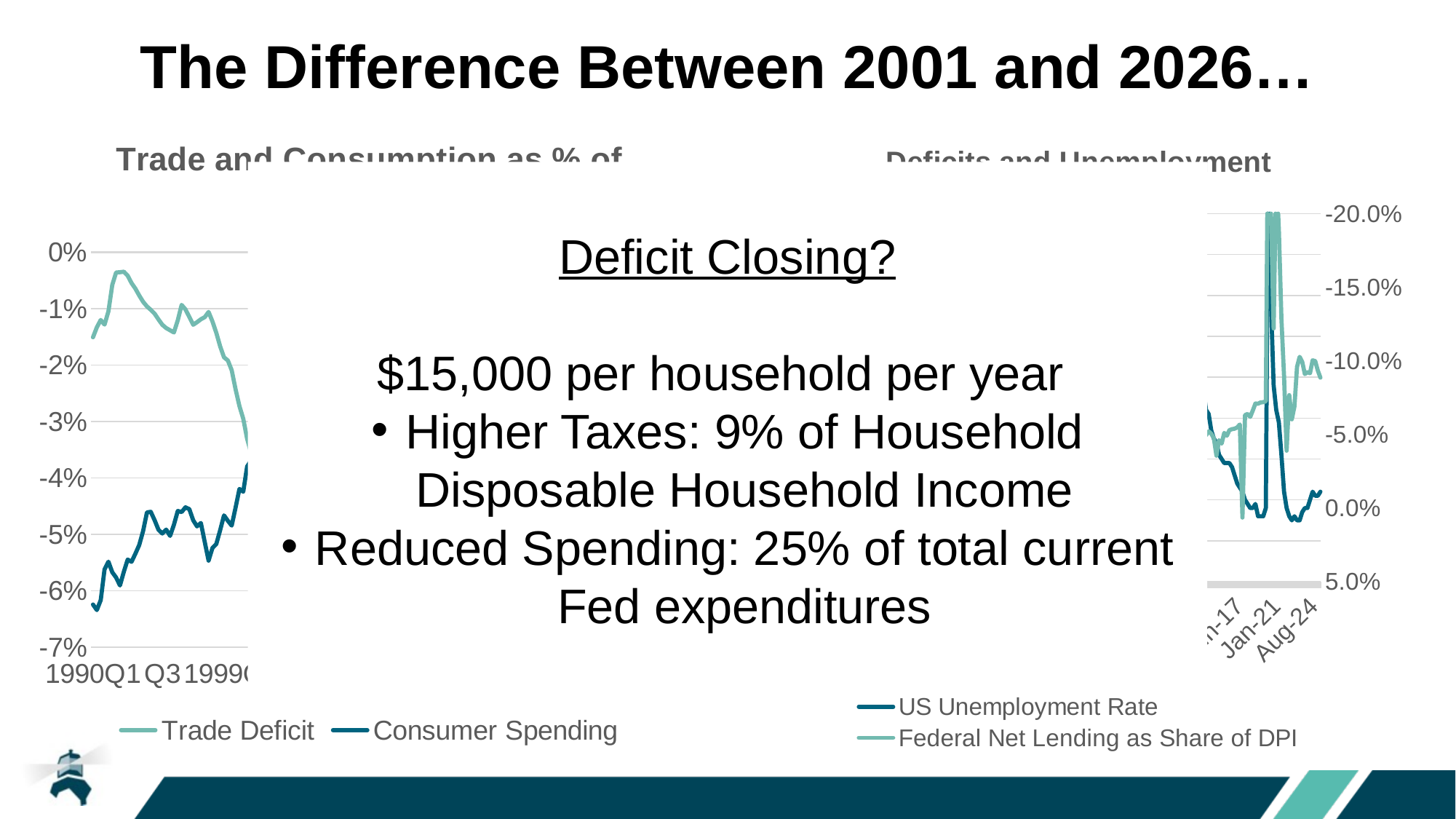
What are the two series named in the legend of the left chart? Trade Deficit and Consumer Spending What are the two series named in the legend of the right chart? US Unemployment Rate and Federal Net Lending as Share of DPI How many series does the legend of the right chart list? 2 How many series does the legend of the left chart list? 2 What is the lowest value shown on the y axis of the left chart? -7% In the left chart, does the Consumer Spending line generally rise or fall from 1990Q1 to the end of the visible period? Rise In the left chart, is the value of Trade Deficit at 1990Q1 greater or less than -2%? greater What is the last x-axis label shown on the right chart? Aug-24 What kind of chart is the right chart, 'Deficits and Unemployment'? Line chart What kind of chart is the left chart, 'Trade and Consumption as % of...'? Line chart